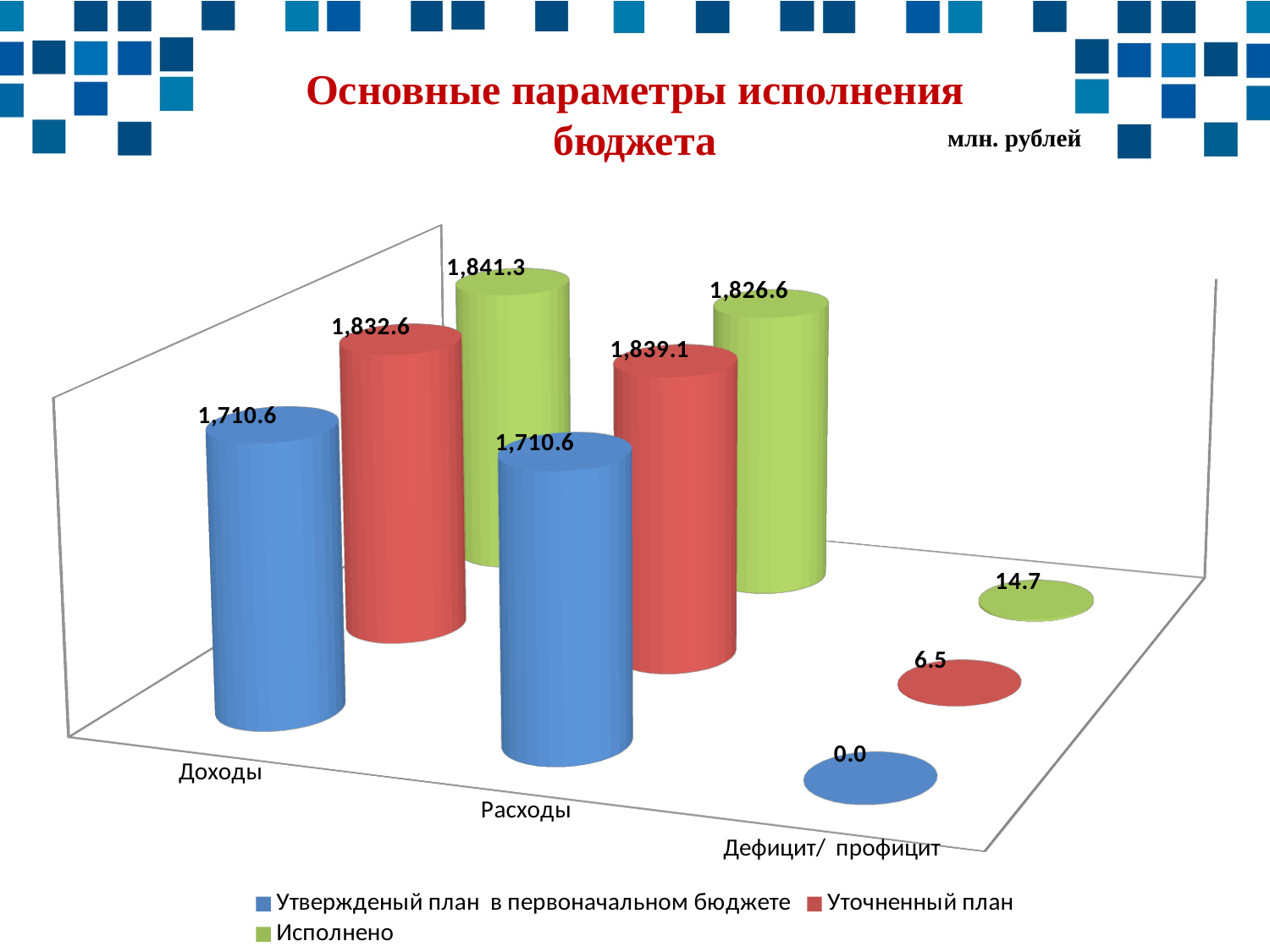
Which is larger for Расходы: Уточненный план or Исполнено? Уточненный план What kind of chart is shown on the slide? Bar chart Which series has the lowest value for Дефицит/ профицит? Утвержденый план в первоначальном бюджете How many categories are shown on the x axis? 3 What is the value of Исполнено for Дефицит/ профицит? 14.7 Which series has the highest value for Доходы? Исполнено What is the value of Уточненный план for Дефицит/ профицит? 6.5 What is the value of Утвержденый план в первоначальном бюджете for Доходы? 1,710.6 What is the value of Уточненный план for Расходы? 1,839.1 What is the value of Исполнено for Доходы? 1,841.3 What is the difference between Уточненный план and Утвержденый план в первоначальном бюджете for Доходы? 122.0 How many series does the legend list? 3